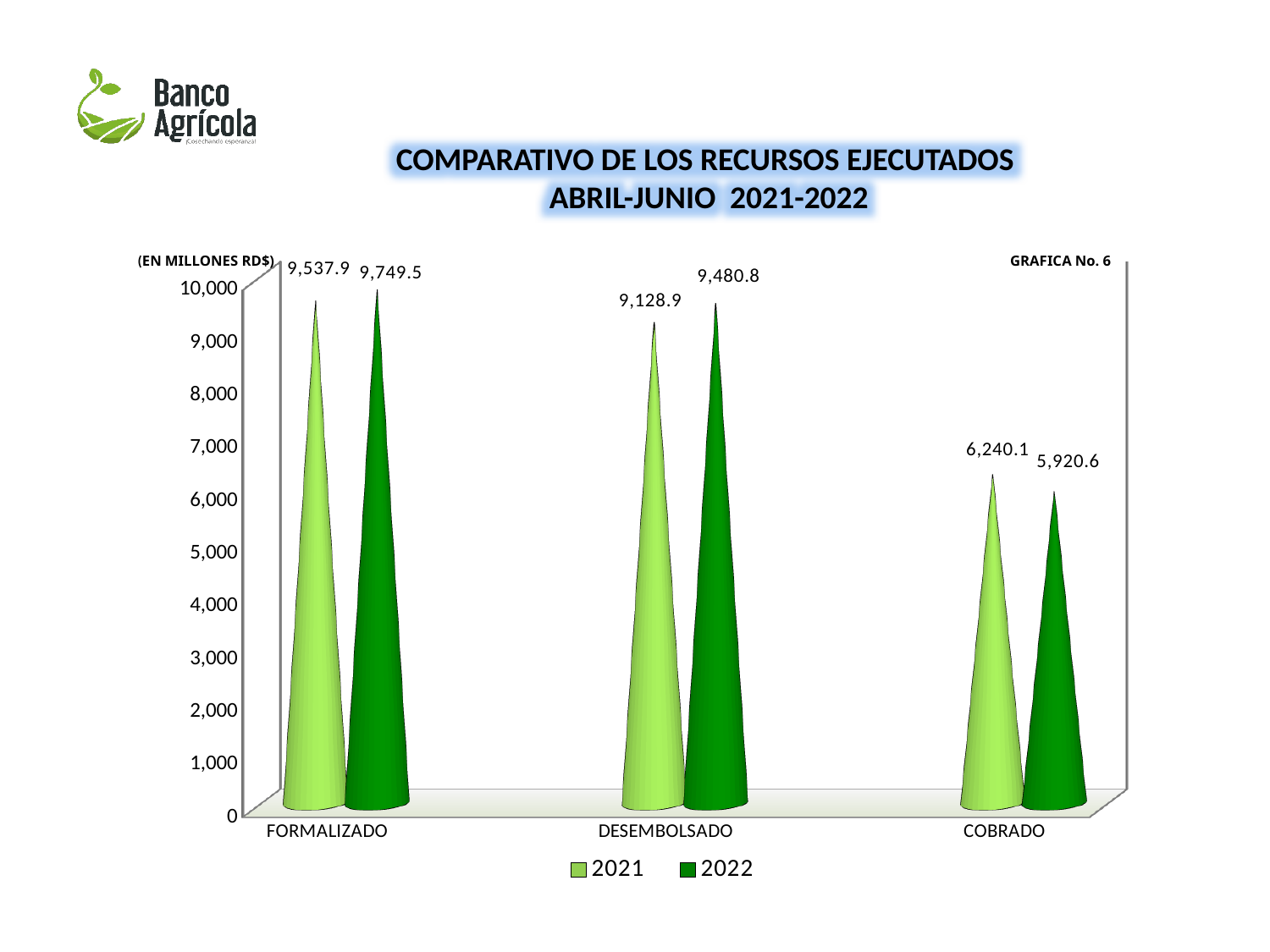
How many categories are shown on the x axis? 3 How many series does the legend list? 2 What is the value for COBRADO in the 2022 series? 5,920.6 What is the value for FORMALIZADO in the 2022 series? 9,749.5 What is the difference between the 2022 and 2021 values for DESEMBOLSADO? 351.9 What is the difference between the 2021 and 2022 values for COBRADO? 319.5 Is the 2021 value for COBRADO greater or less than 7,000? less What is the value for DESEMBOLSADO in the 2021 series? 9,128.9 Which category has the lowest value in the 2021 series? COBRADO Which category has the highest value in the 2022 series? FORMALIZADO For COBRADO, which series has the larger value, 2021 or 2022? 2021 What kind of chart is shown on the slide? bar chart